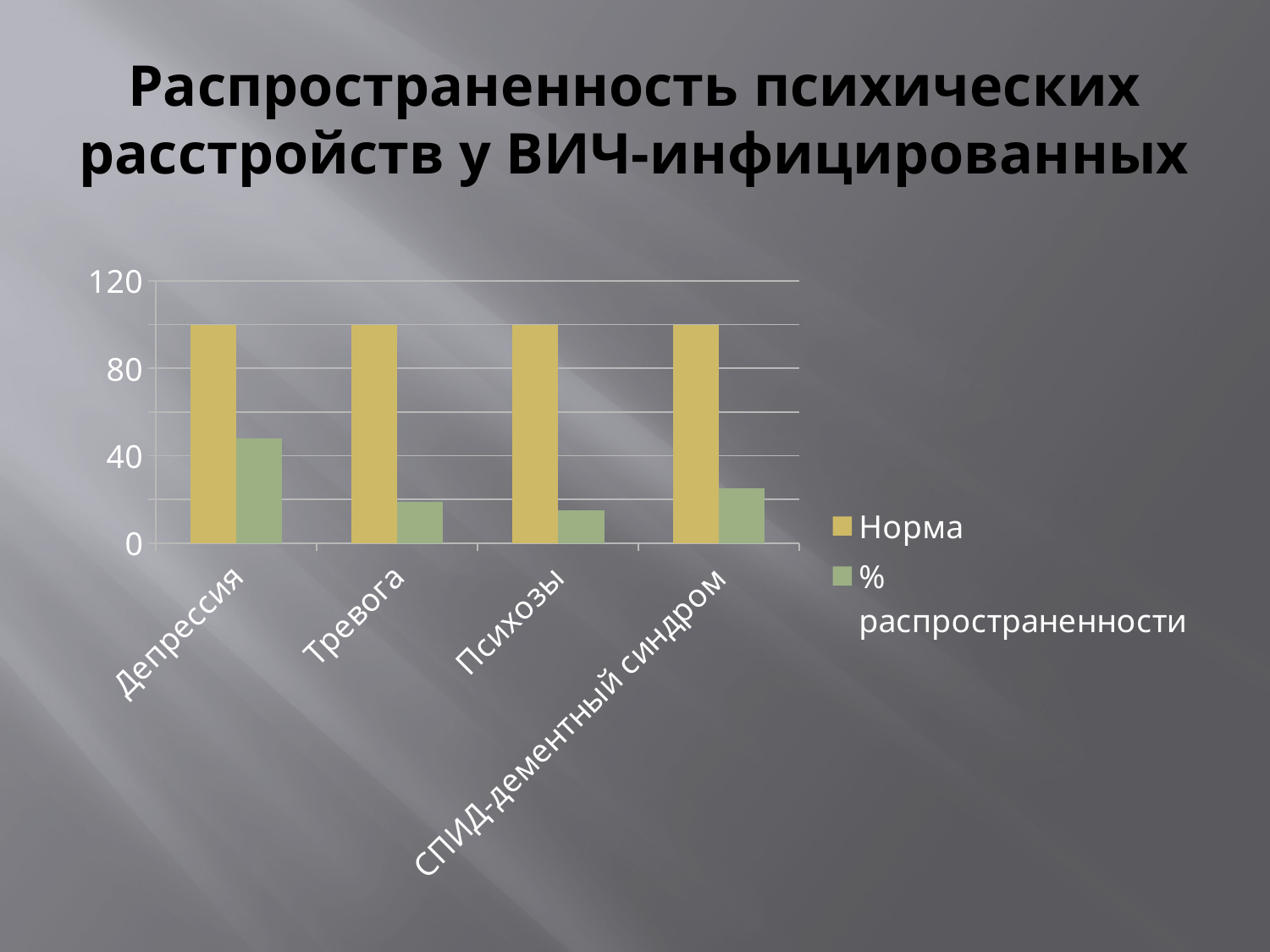
Is the value of % распространенности for Депрессия greater or less than 40? greater How many series does the chart's legend list? 2 Which is larger for the series % распространенности: Депрессия or СПИД-дементный синдром? Депрессия What kind of chart is shown on the slide? bar chart Is the value of Норма for Депрессия greater or less than 80? greater What is the title of the chart on the slide? Распространенность психических расстройств у ВИЧ-инфицированных Is the value of % распространенности for Психозы greater or less than 40? less Which series is shown in green in the chart? % распространенности Which is larger for the series % распространенности: Психозы or Депрессия? Депрессия How many categories are shown on the x axis of the chart? 4 Which category has the highest value for the series % распространенности? Депрессия